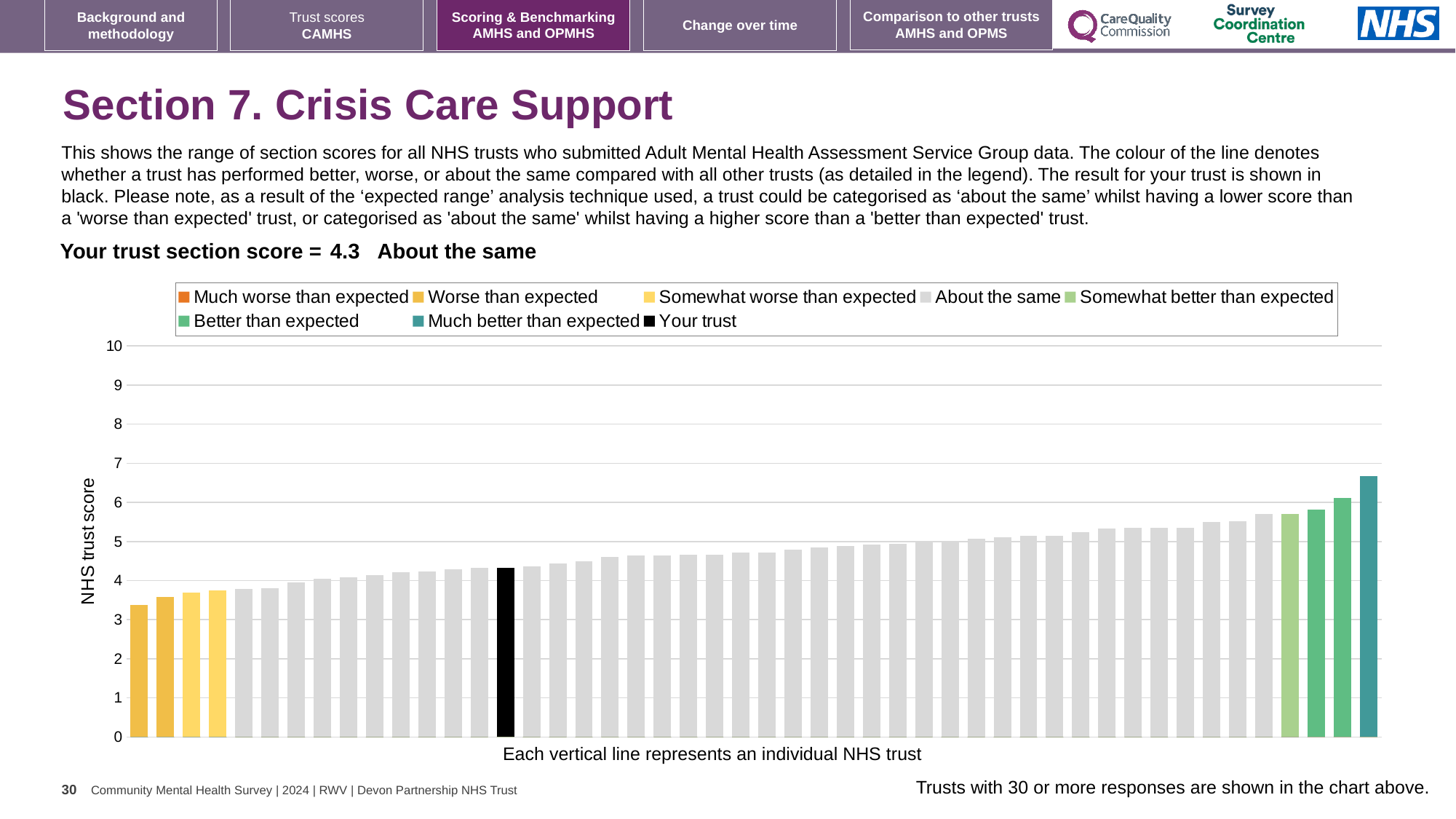
Do the bar values rise or fall from left to right along the x axis? rise Which legend category does the shortest bar belong to? Worse than expected How many entries does the chart legend list? 8 Is the value for the shortest bar greater or less than 4? less Which is larger, the leftmost bar or the rightmost bar? the rightmost bar What kind of chart is shown on the slide? bar chart What colour is the bar for your trust? black Is the value for the tallest bar greater or less than 6? greater What is the section score for your trust shown on the slide? 4.3 Is the value for the tallest bar greater or less than 7? less Which legend category does the tallest bar belong to? Much better than expected Which category is your trust placed in according to the slide? About the same